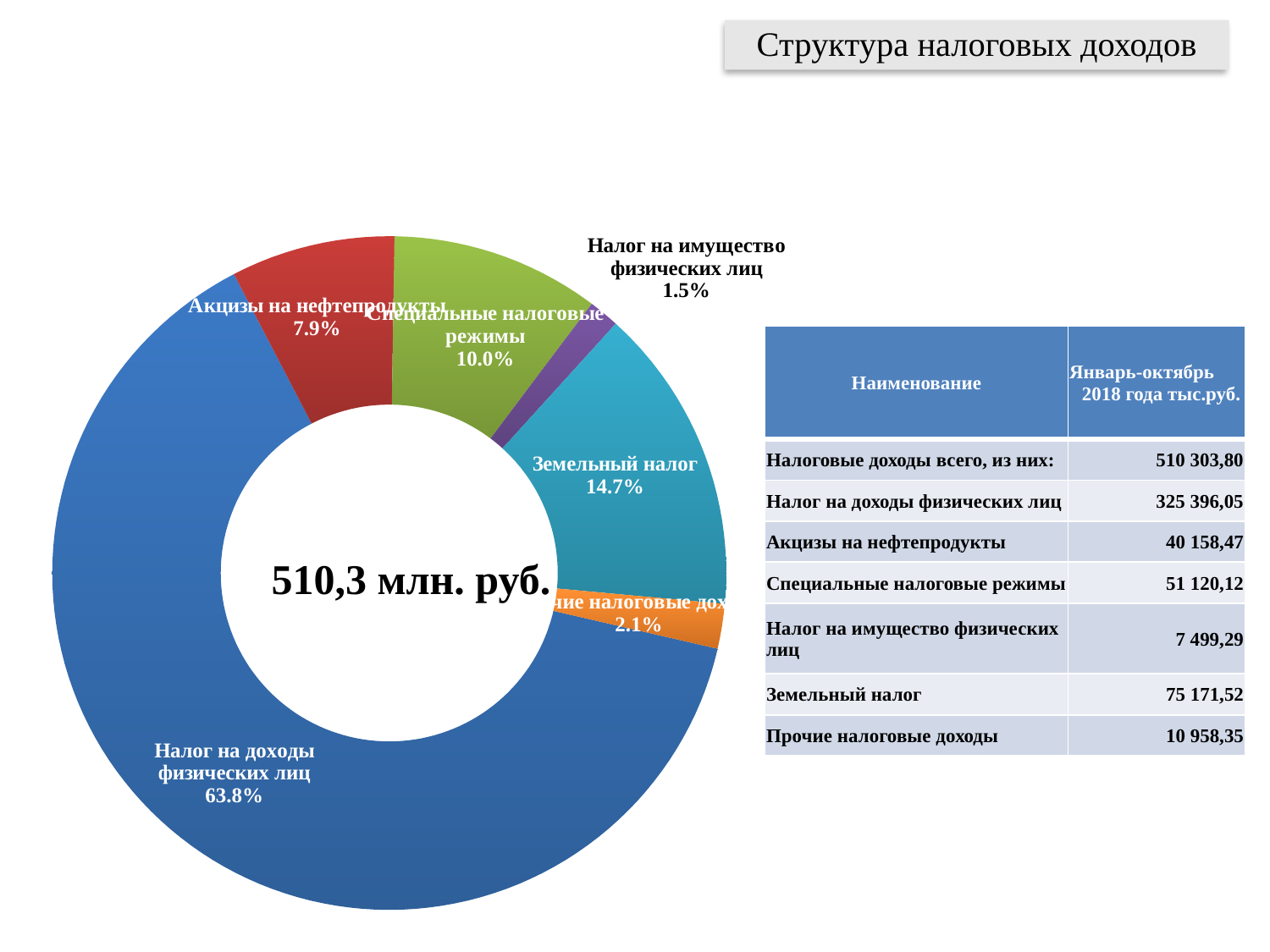
What share of the doughnut chart does "Акцизы на нефтепродукты" have? 7.9% What share of the doughnut chart does "Специальные налоговые режимы" have? 10.0% In the doughnut chart, which is larger: "Земельный налог" or "Специальные налоговые режимы"? Земельный налог What kind of chart is shown on the slide? doughnut (pie) chart How many slices does the doughnut chart have? 6 What total value is printed in the centre of the doughnut chart? 510,3 млн. руб. What share of the doughnut chart does "Земельный налог" have? 14.7% Which category has the smallest slice in the doughnut chart? Налог на имущество физических лиц Which category has the largest slice in the doughnut chart? Налог на доходы физических лиц What is the difference in percentage points between "Земельный налог" and "Акцизы на нефтепродукты" in the doughnut chart? 6.8 percentage points What share of the doughnut chart does "Налог на доходы физических лиц" have? 63.8% What share of the doughnut chart does "Налог на имущество физических лиц" have? 1.5%